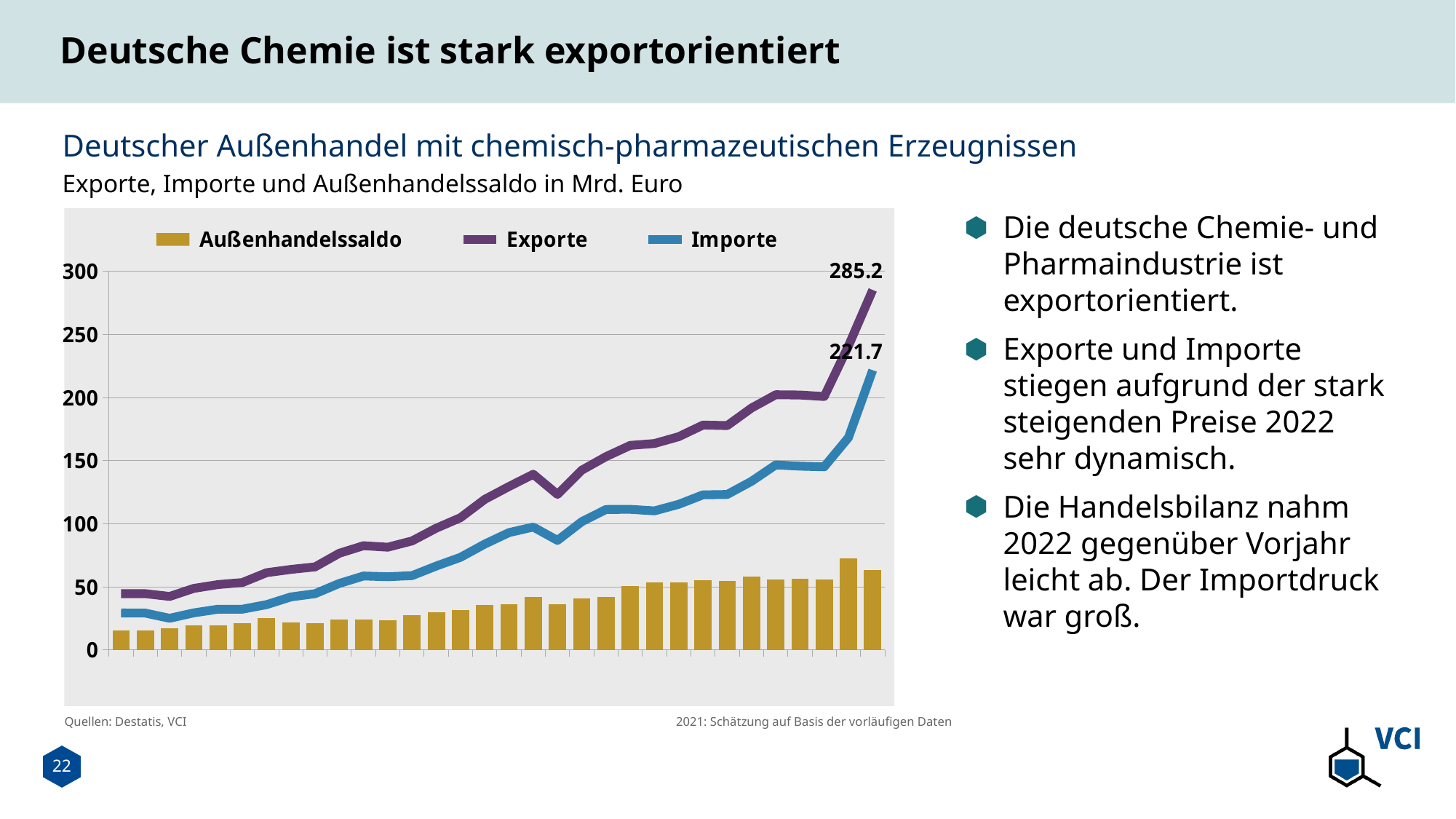
Which series is plotted as bars rather than a line? Außenhandelssaldo What kind of chart is shown on the slide? Combined bar and line chart In what unit are the values on the chart given, according to the subtitle? Mrd. Euro What is the value printed at the final point of the Importe line? 221.7 Is the value of the first Exporte point greater or less than 100? less At the final data point, which is larger: Exporte or Importe? Exporte How many series does the chart legend list? 3 Which series reaches the highest value at the end of the chart? Exporte What is the value printed at the final point of the Exporte line? 285.2 Is the value of the last Außenhandelssaldo bar greater or less than 100? less Do the Exporte values generally rise or fall from left to right along the x axis? rise What is the difference between the final Exporte value (285.2) and the final Importe value (221.7)? 63.5